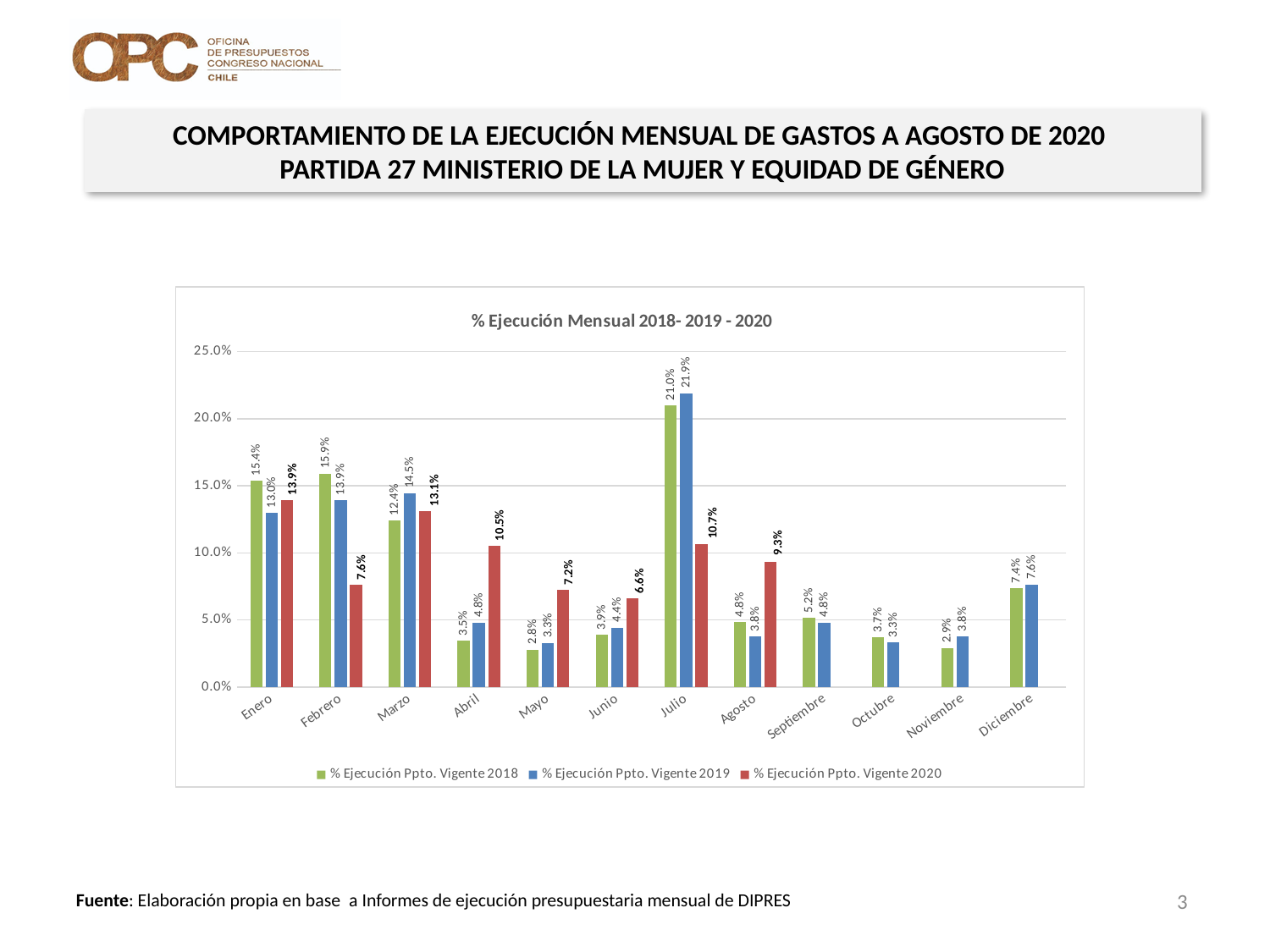
How many months are shown on the x axis? 12 Is the value for Marzo in the 2019 series greater or less than 10.0%? greater Which month has the lowest value in the % Ejecución Ppto. Vigente 2020 series? Junio Which month has the highest value in the % Ejecución Ppto. Vigente 2018 series? Julio How many series does the legend list? 3 What is the value for Abril in the % Ejecución Ppto. Vigente 2020 series? 10.5% What kind of chart is shown on the slide? Bar chart What is the difference between the 2019 and 2018 values for Julio? 0.9% Which is larger for Agosto: the 2018 value or the 2020 value? 2020 value (9.3%) What is the value for Julio in the % Ejecución Ppto. Vigente 2019 series? 21.9% What is the value for Febrero in the % Ejecución Ppto. Vigente 2018 series? 15.9% What is the title of the chart? % Ejecución Mensual 2018- 2019 - 2020